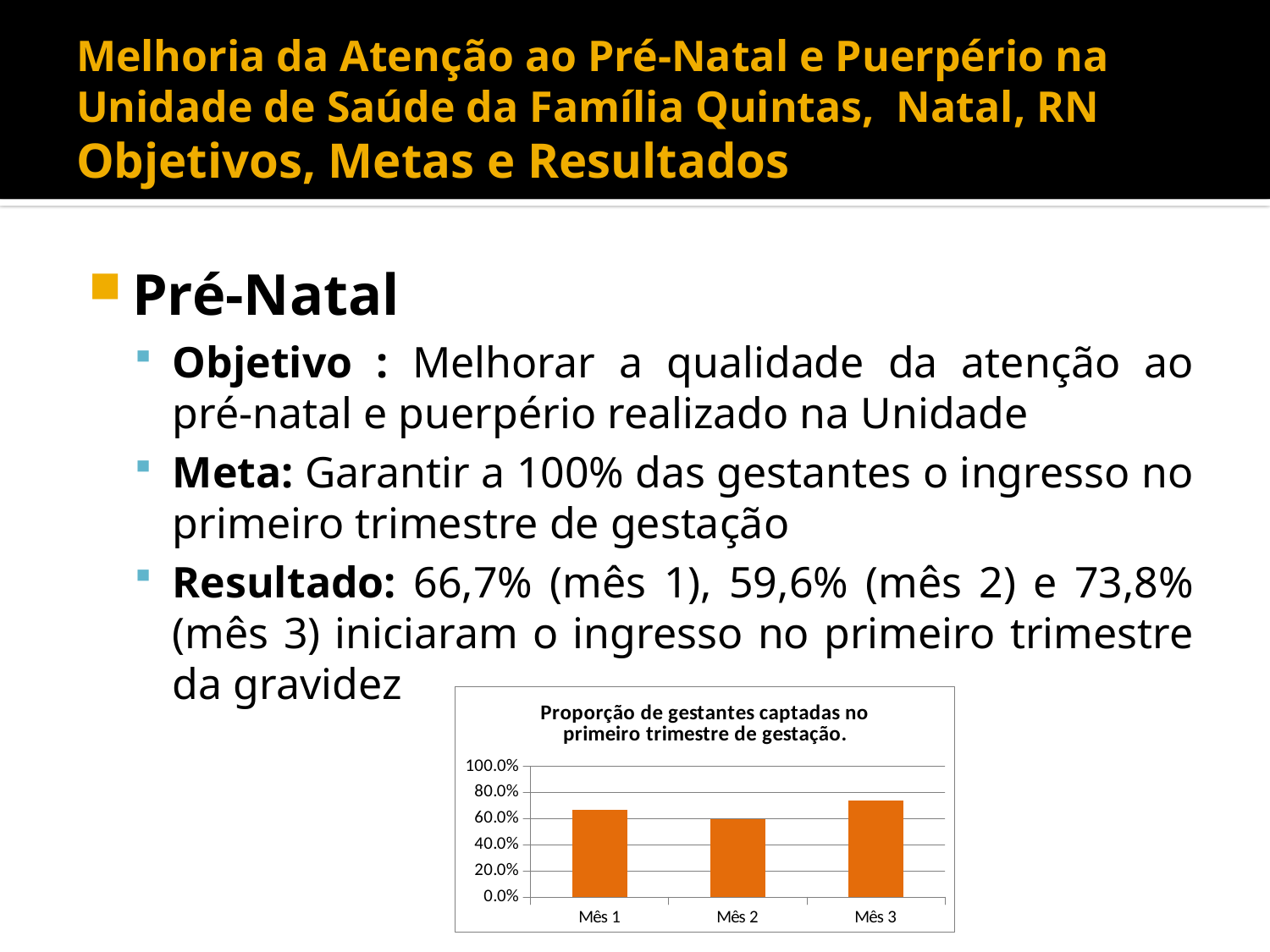
Is the value for Mês 2 greater or less than 60.0%? less Does the value rise or fall from Mês 2 to Mês 3? rise Which month has the lowest bar in the chart? Mês 2 Is the value for Mês 3 greater or less than 60.0%? greater According to the slide, what proportion of pregnant women was captured in the first trimester in mês 3? 73,8% Which is larger, the value for Mês 1 or the value for Mês 2? Mês 1 What kind of chart is shown on the slide? bar chart Is the value for Mês 1 greater or less than 80.0%? less According to the slide, what proportion of pregnant women was captured in the first trimester in mês 2? 59,6% What is the title of the chart on the slide? Proporção de gestantes captadas no primeiro trimestre de gestação. How many categories (months) are plotted in the chart? 3 Which month has the highest bar in the chart? Mês 3